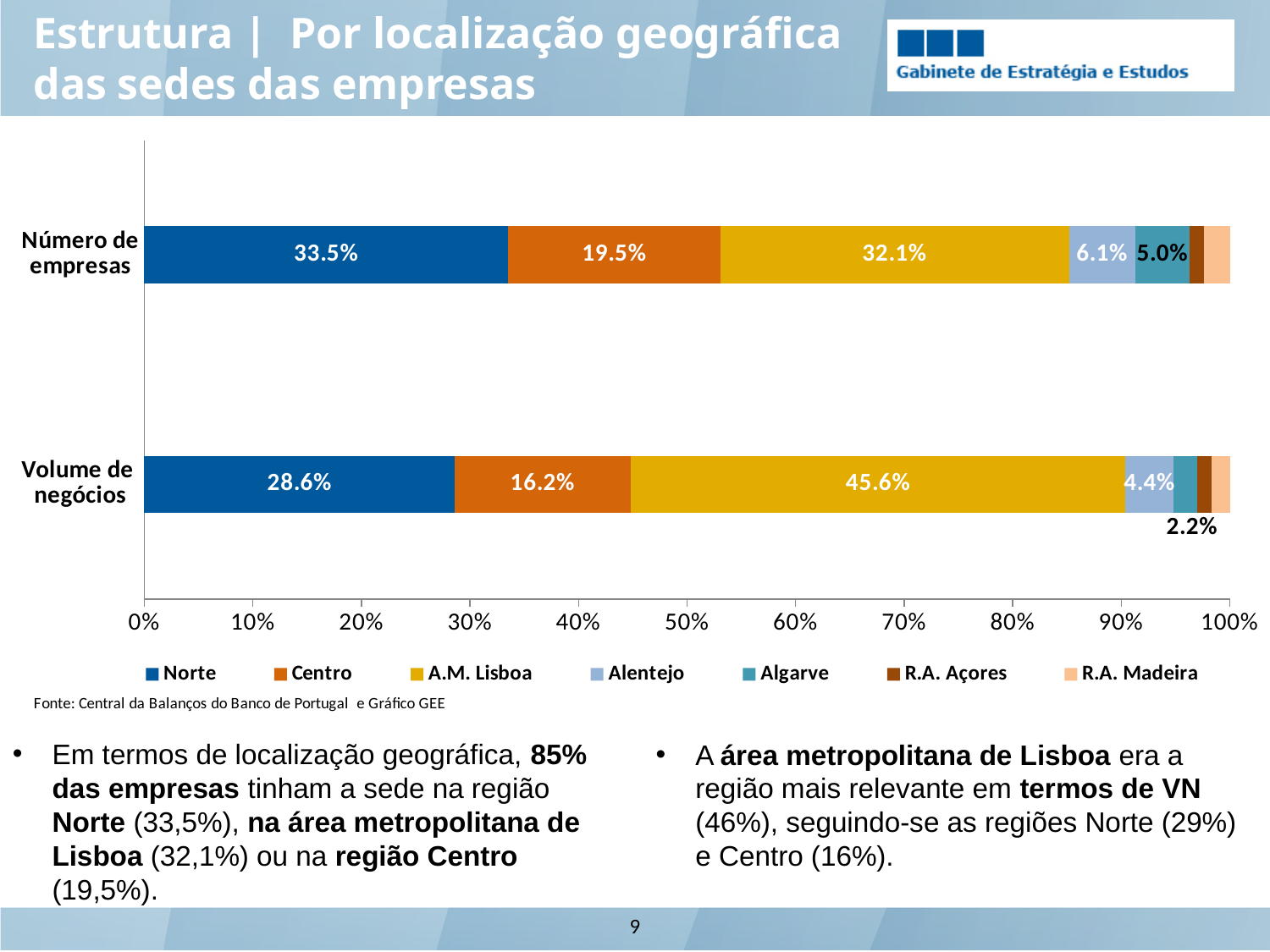
What share of Número de empresas is attributed to Norte? 33.5% What kind of chart is shown on the slide? Stacked bar chart What is the value for Centro in the Número de empresas bar? 19.5% Which region has the largest segment in the Número de empresas bar? Norte Is the Centro share larger for Número de empresas or for Volume de negócios? Número de empresas By how many percentage points does Norte exceed Centro in the Número de empresas bar? 14.0 percentage points How many bars (categories) does the chart show? 2 What is the value for Algarve in the Número de empresas bar? 5.0% What is the value for Alentejo in the Volume de negócios bar? 4.4% How many series does the legend list? 7 Which region has the largest segment in the Volume de negócios bar? A.M. Lisboa What share of Volume de negócios is attributed to A.M. Lisboa? 45.6%